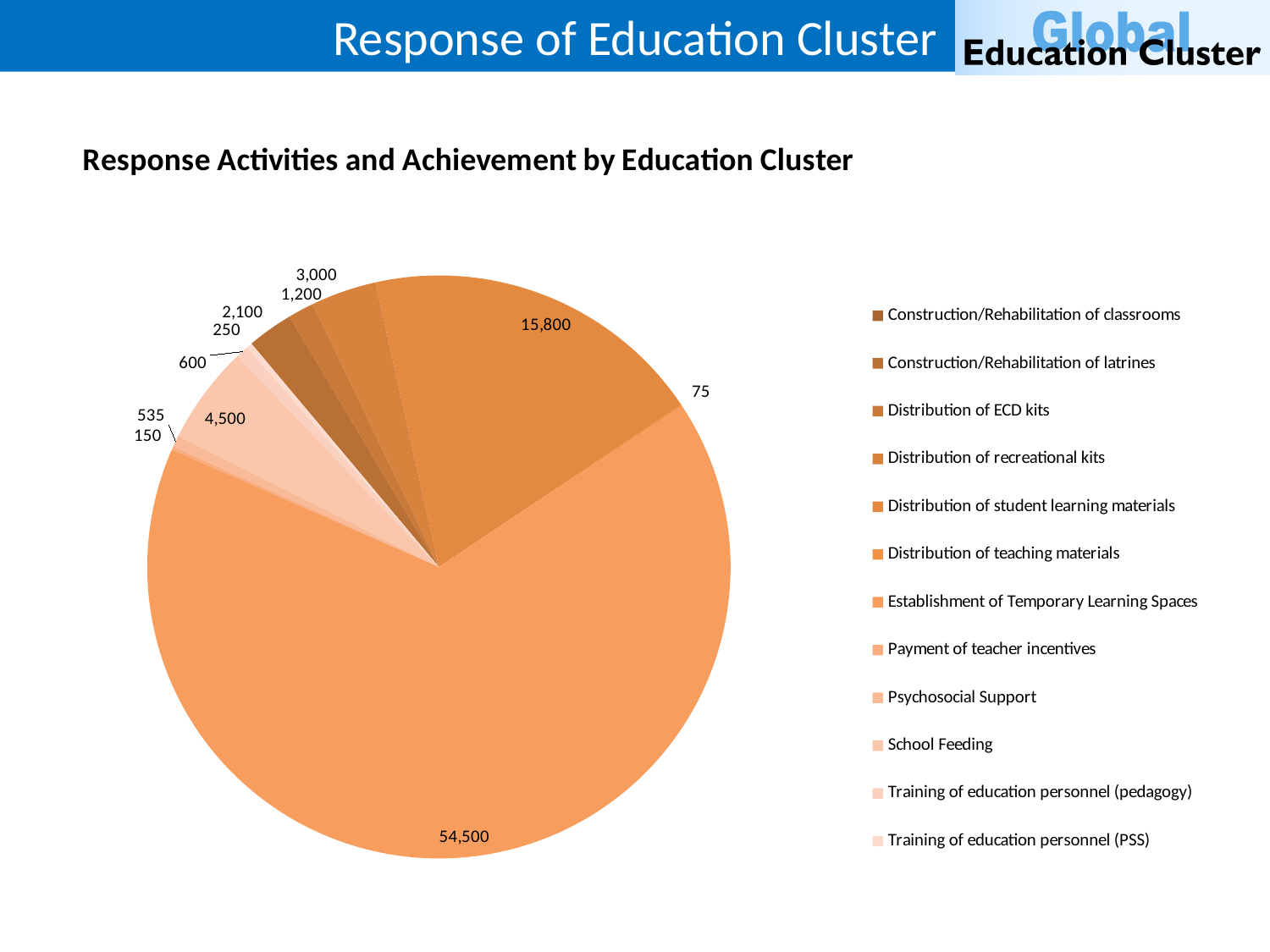
How many categories does the chart's legend list? 12 What is the second-largest value labelled on the pie chart? 15,800 Which is larger, the slice labelled 4,500 or the slice labelled 3,000? 4,500 What is the first category listed in the chart's legend? Construction/Rehabilitation of classrooms Which is larger, the slice labelled 600 or the slice labelled 535? 600 What type of chart is shown on the slide? pie chart What is the difference between the largest labelled slice (54,500) and the second-largest (15,800)? 38,700 What is the difference between the slices labelled 3,000 and 1,200? 1,800 What is the title of the chart? Response Activities and Achievement by Education Cluster What is the difference between the slices labelled 4,500 and 2,100? 2,400 What is the largest value labelled on the pie chart? 54,500 What is the smallest value labelled on the pie chart? 75